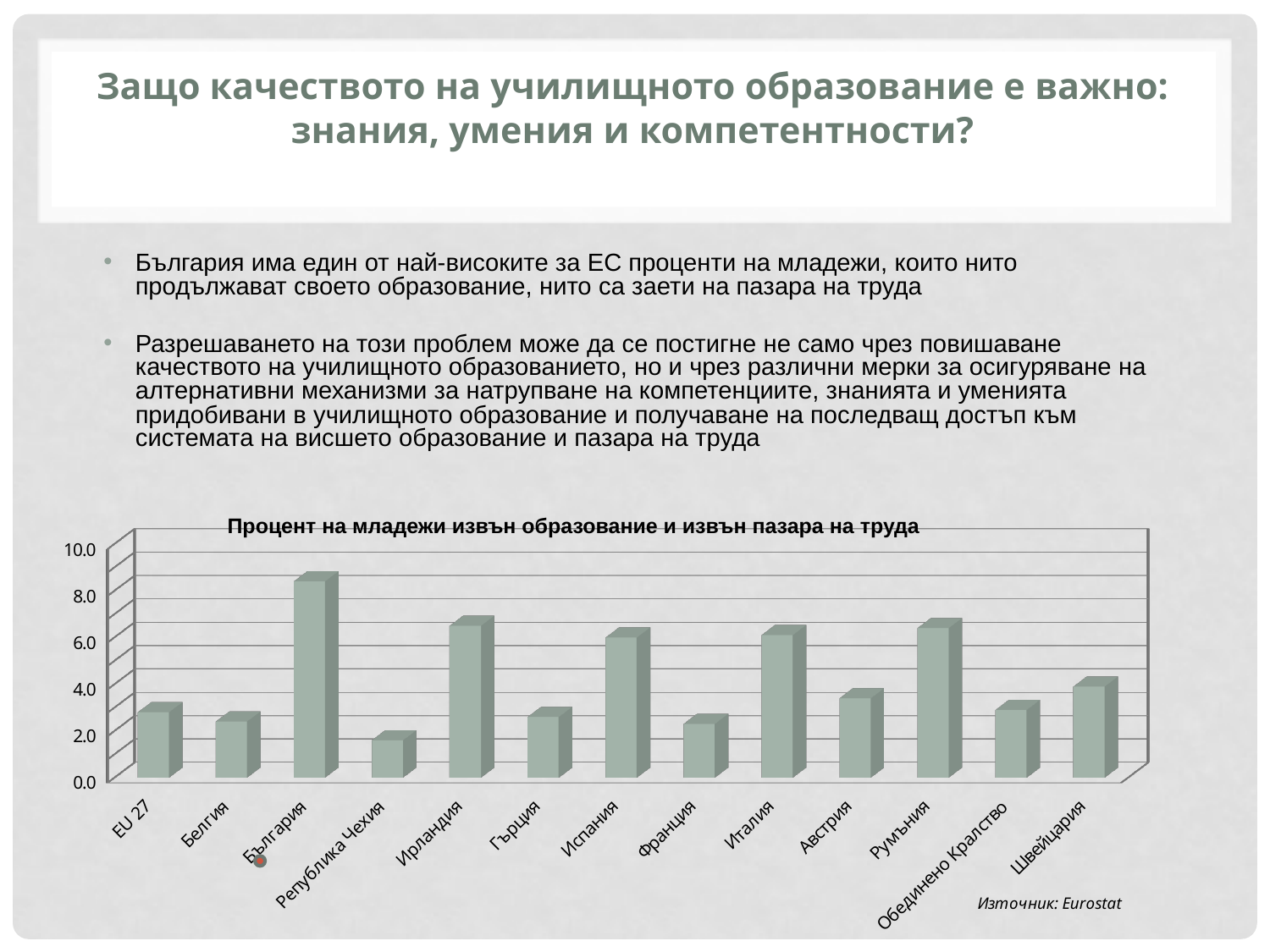
Which category has the highest value on the chart? България How many categories are plotted on the chart? 13 Is the value for Република Чехия greater or less than 2.0? less Which category has the lowest value on the chart? Република Чехия What kind of chart is shown on the slide? Bar chart Is the value for България greater or less than 6.0? greater Which is larger, the value for България or the value for Ирландия? България Is the value for Ирландия greater or less than 6.0? greater What is the title of the chart? Процент на младежи извън образование и извън пазара на труда What source is cited below the chart? Eurostat Which is larger, the value for Република Чехия or the value for Швейцария? Швейцария